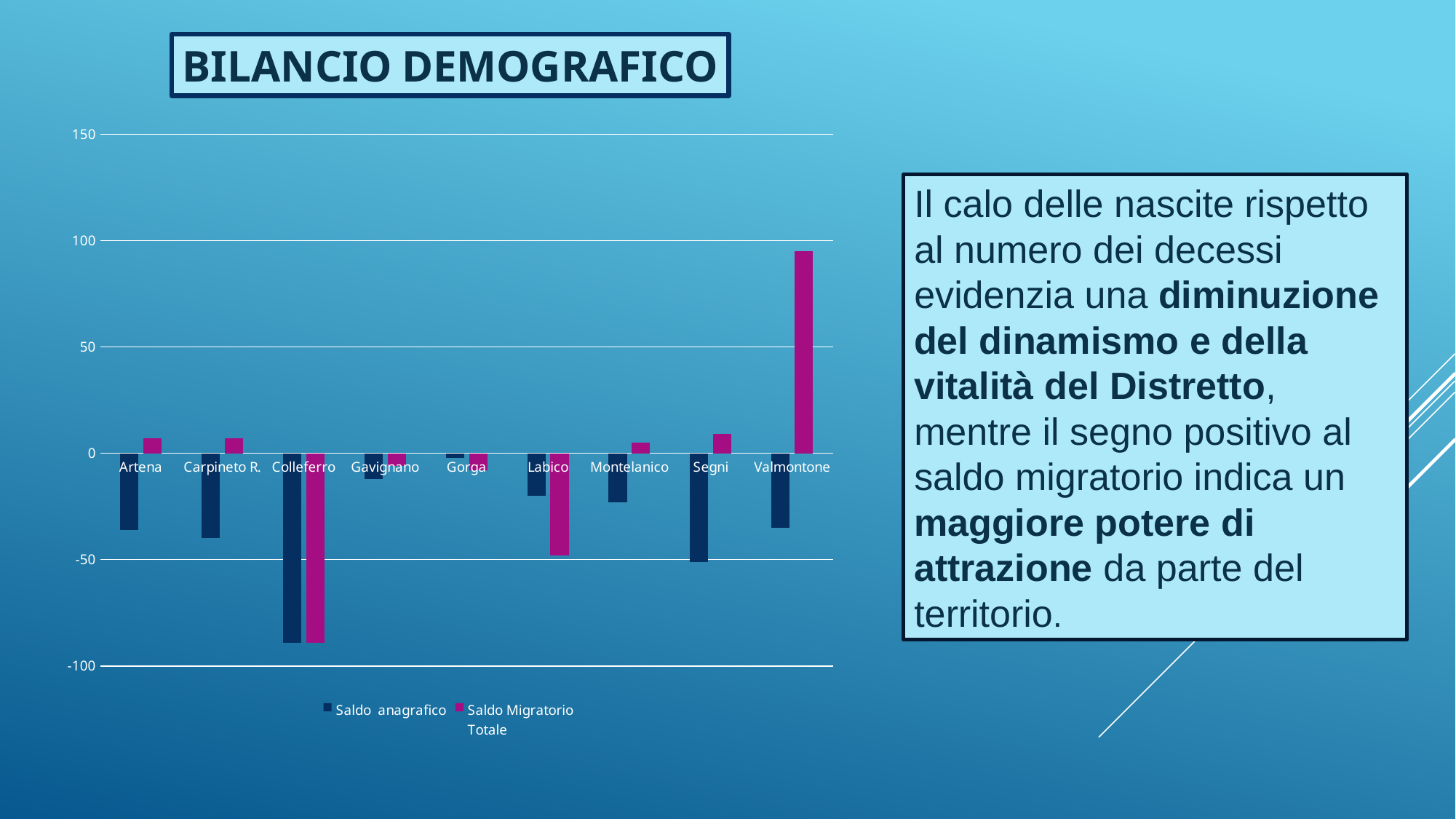
Is the Saldo Migratorio Totale value for Valmontone greater or less than 50? greater Is the Saldo anagrafico value for Artena greater or less than 0? less Which series is drawn in magenta in the chart? Saldo Migratorio Totale Which category has the highest Saldo Migratorio Totale value? Valmontone What kind of chart is shown on the slide? bar chart How many series does the chart legend list? 2 How many municipalities (categories) are shown on the x axis of the chart? 9 What is the title shown above the chart? BILANCIO DEMOGRAFICO Is the Saldo anagrafico value for Colleferro greater or less than -50? less Which is larger, the Saldo Migratorio Totale for Valmontone or for Segni? Valmontone Which is larger, the Saldo anagrafico for Gorga or for Colleferro? Gorga Which category has the lowest Saldo anagrafico value? Colleferro